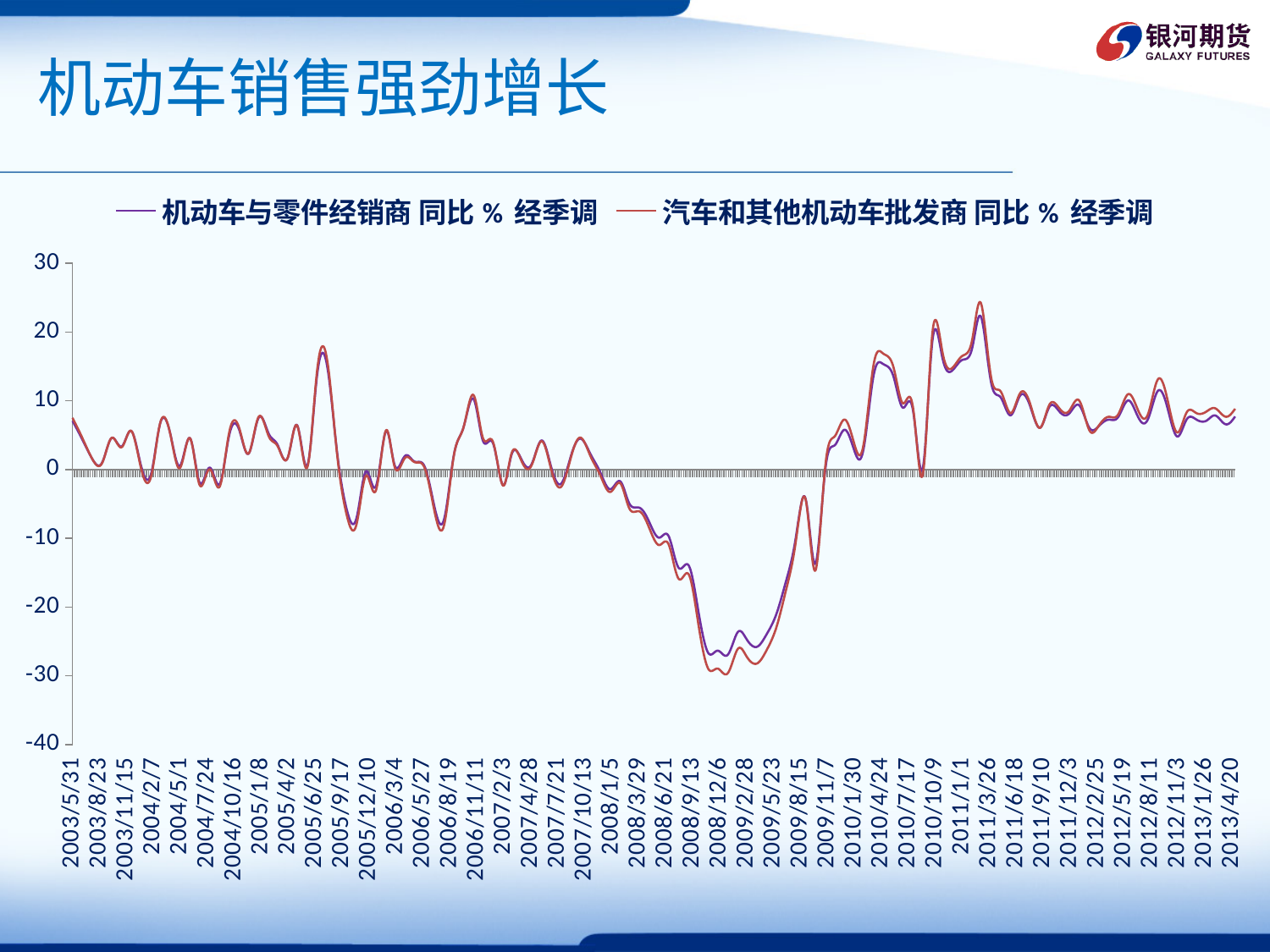
What kind of chart is shown on the slide? line chart What is the lowest value shown on the vertical axis? -40 Around 2009/2/28, which series has the lower value, the red series or the purple series? the red series (汽车和其他机动车批发商 同比 % 经季调) Which series is drawn in red according to the legend? 汽车和其他机动车批发商 同比 % 经季调 Is the value of the red series (汽车和其他机动车批发商) around 2011/1/1 greater or less than 10? greater Is the value of the red series (汽车和其他机动车批发商) around 2009/2/28 greater or less than -20? less Do the values of the red series rise or fall between 2008/1/5 and 2008/12/6? fall Is the value of the red series (汽车和其他机动车批发商) around 2013/4/20 greater or less than 0? greater How many series does the legend list? 2 Do the values of the red series rise or fall between 2009/2/28 and 2010/4/24? rise What is the title of the slide above the chart? 机动车销售强劲增长